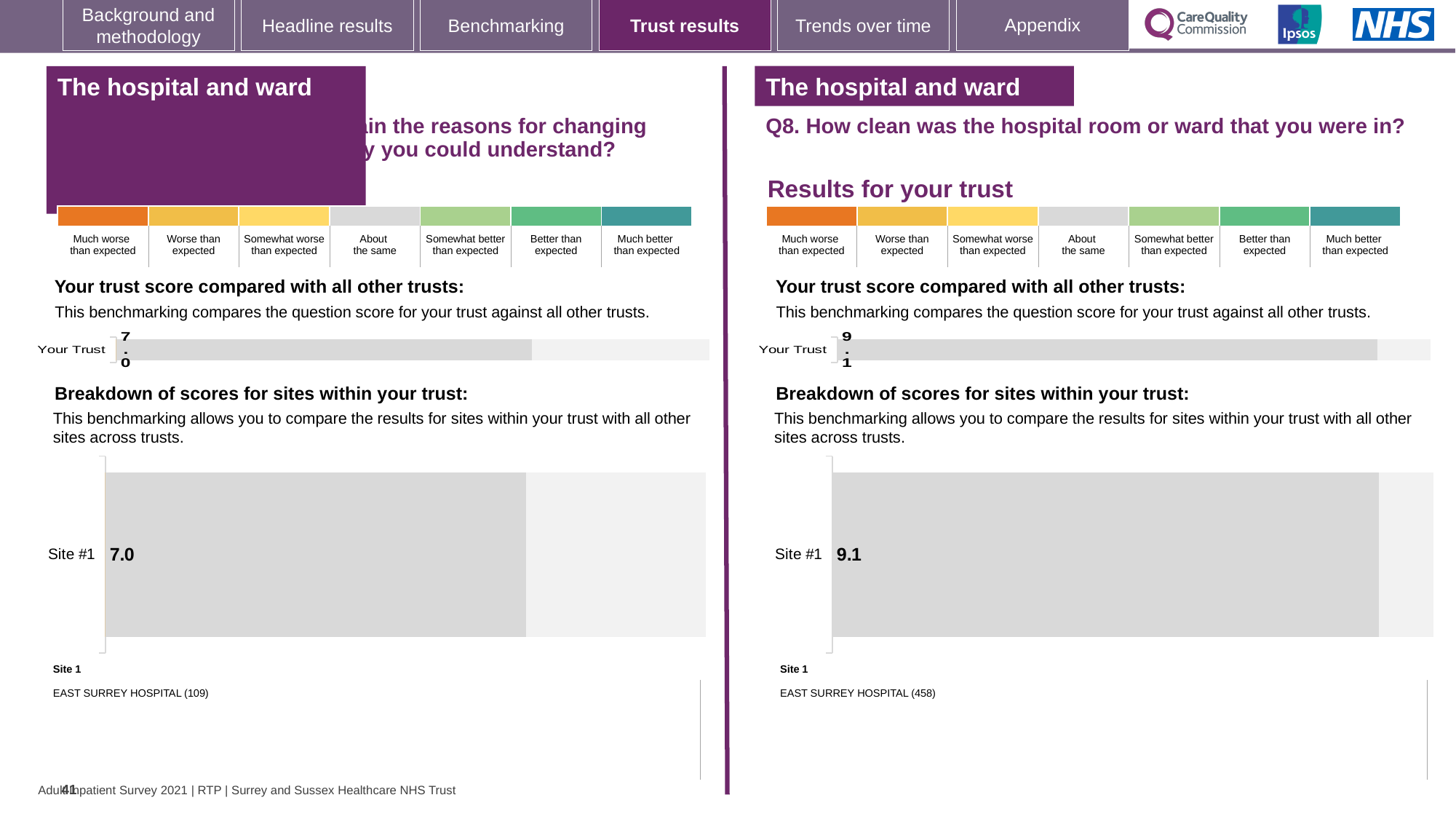
Is the Site #1 score on the left-hand panel greater or less than the Site #1 score on the right-hand panel (Q8)? less How many sites are shown in the breakdown of scores chart on the right-hand panel (Q8)? 1 On the left-hand panel, what score is shown for Site #1 in the breakdown of scores for sites within your trust? 7.0 What kind of chart is used to show the Site #1 score on the right-hand panel (Q8)? bar chart On the right-hand panel (Q8), which hospital is listed as Site 1? EAST SURREY HOSPITAL (458) What is the difference between the Site #1 score on the right-hand panel (Q8) and the Site #1 score on the left-hand panel? 2.1 On the right-hand panel (Q8), what score is shown for Site #1 in the breakdown of scores for sites within your trust? 9.1 On the right-hand panel (Q8, how clean was the hospital room or ward), what is the score shown for Your Trust? 9.1 On the left-hand panel, which hospital is listed as Site 1? EAST SURREY HOSPITAL (109) Which panel shows the higher Your Trust score, the left-hand panel or the right-hand panel (Q8)? the right-hand panel (Q8) On the left-hand panel, what is the score shown for Your Trust? 7.0 How many sites are shown in the breakdown of scores chart on the left-hand panel? 1